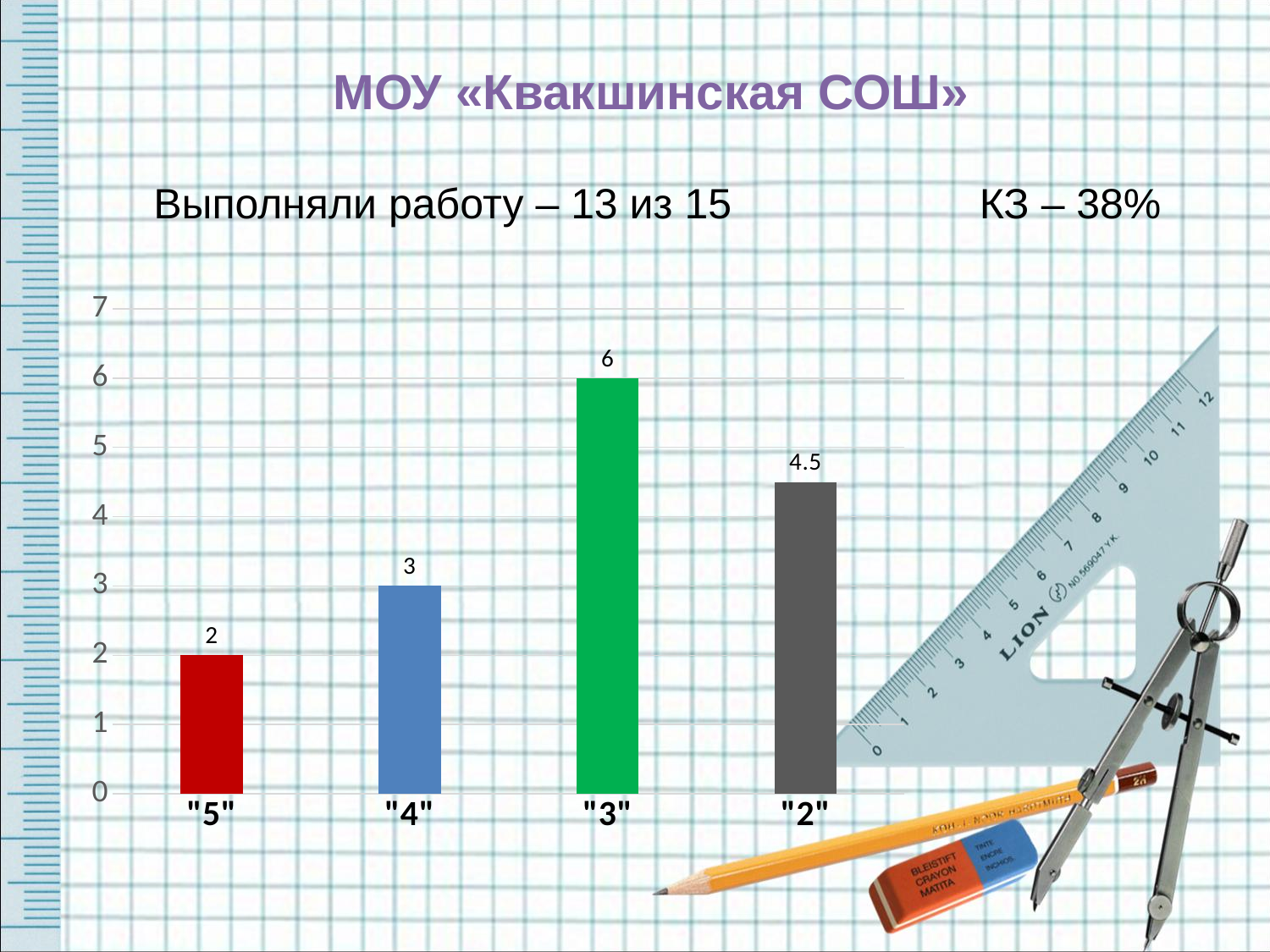
What is the value for the "3" category? 6 Which is larger, the value for "4" or the value for "2"? "2" Is the value for "2" greater or less than 4? greater What is the difference between the values for "2" and "5"? 2.5 What is the difference between the values for "3" and "4"? 3 What is the value for the "5" category? 2 What colour is the bar for the "3" category? green What kind of chart is shown on the slide? bar chart How many categories are shown on the chart? 4 Which category has the highest value? "3" What is the value for the "2" category? 4.5 Which category has the lowest value? "5"